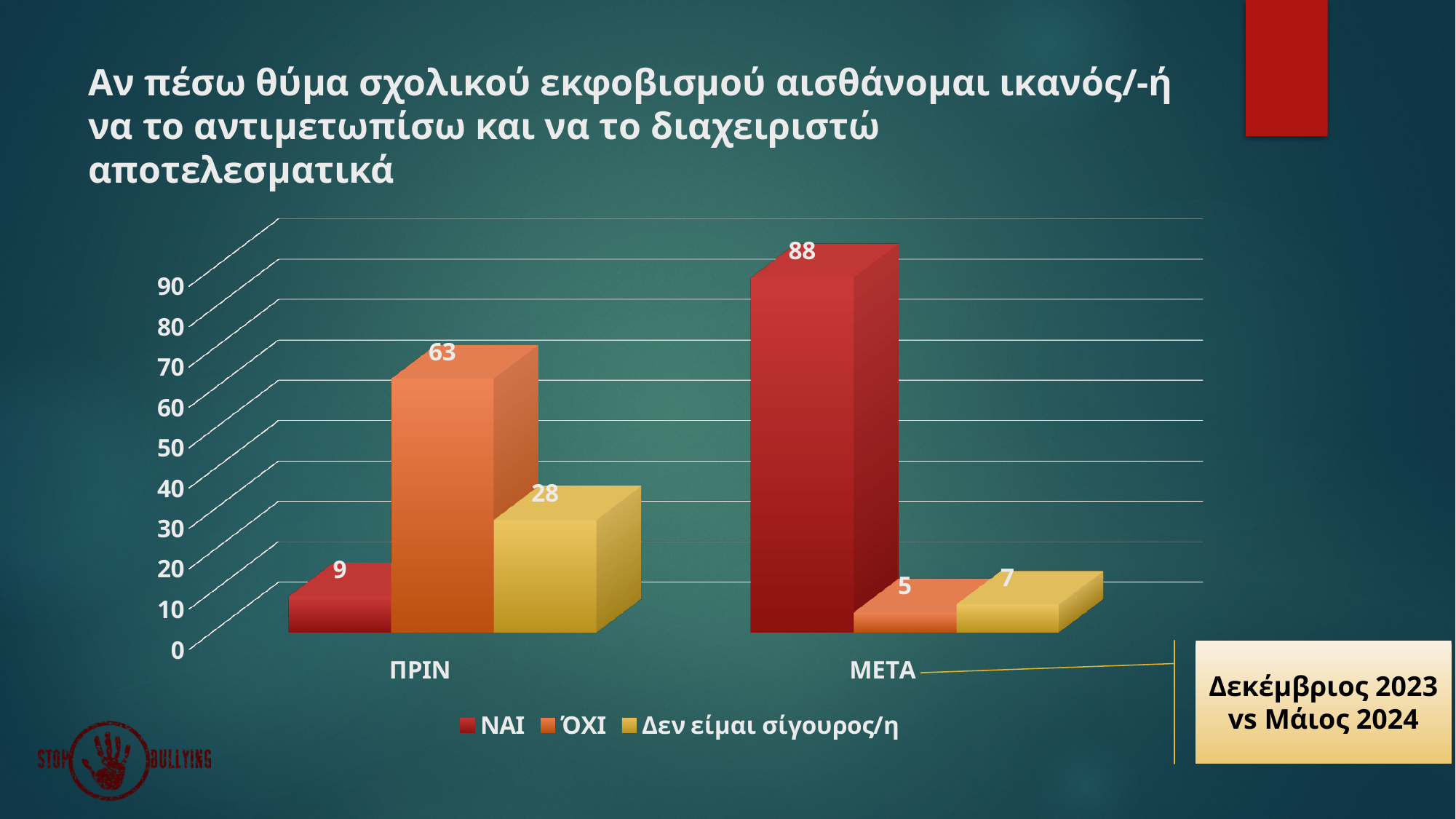
Which is larger: ΌΧΙ in ΠΡΙΝ or Δεν είμαι σίγουρος/η in ΠΡΙΝ? ΌΧΙ in ΠΡΙΝ How many series does the legend list? 3 How many categories are shown on the x axis? 2 What is the difference between the ΝΑΙ values for ΜΕΤΑ and ΠΡΙΝ? 79 Which series has the lowest value in the ΠΡΙΝ category? ΝΑΙ What is the value for ΌΧΙ in the ΠΡΙΝ category? 63 What is the value for Δεν είμαι σίγουρος/η in the ΜΕΤΑ category? 7 What is the value for ΝΑΙ in the ΠΡΙΝ category? 9 Which series has the highest value in the ΜΕΤΑ category? ΝΑΙ Does the ΌΧΙ value rise or fall from ΠΡΙΝ to ΜΕΤΑ? Fall What kind of chart is shown on the slide? Bar chart What is the value for ΝΑΙ in the ΜΕΤΑ category? 88